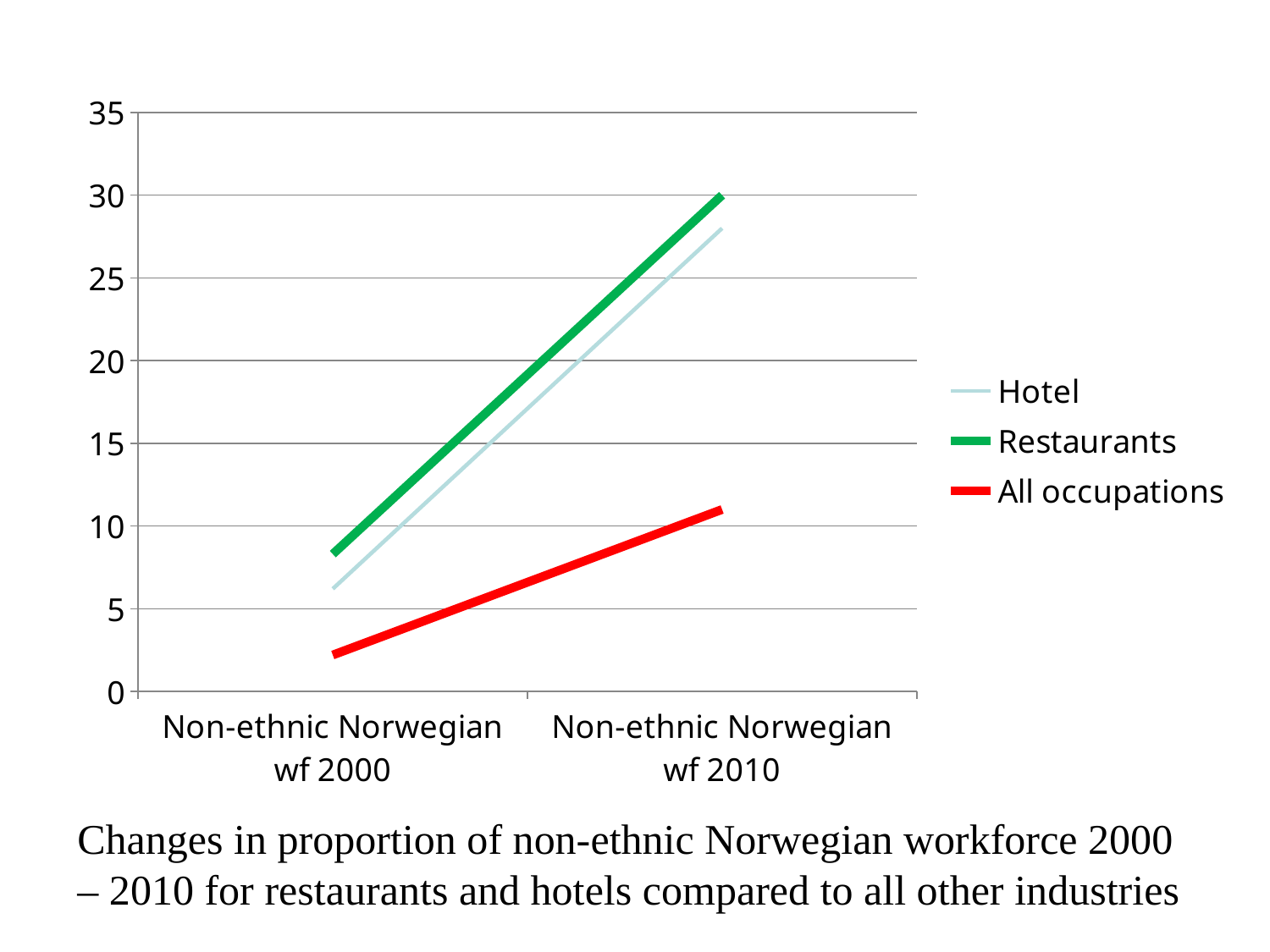
Is the value for All occupations at Non-ethnic Norwegian wf 2010 greater or less than 15? less Is the value for Hotel at Non-ethnic Norwegian wf 2000 greater or less than 10? less What colour is the line for the Restaurants series? green Which series has the highest value for Non-ethnic Norwegian wf 2010? Restaurants How many series does the legend list? 3 Which series has the lowest value for Non-ethnic Norwegian wf 2010? All occupations What kind of chart is shown on the slide? line chart How many categories are shown on the x axis? 2 Does the All occupations series rise or fall from 2000 to 2010? rise Which is larger at Non-ethnic Norwegian wf 2000, the value for Restaurants or the value for Hotel? Restaurants Is the value for All occupations at Non-ethnic Norwegian wf 2000 greater or less than 5? less